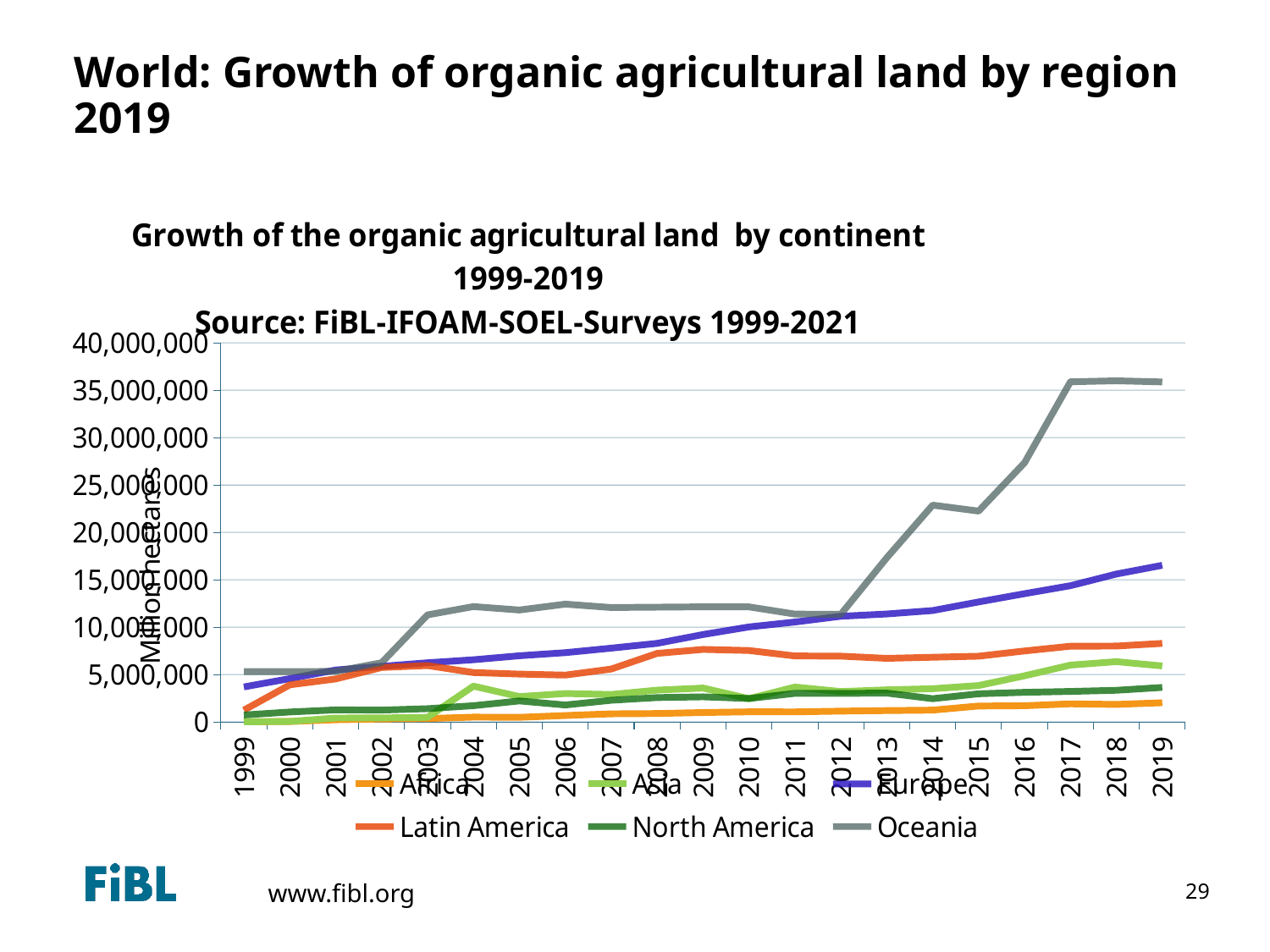
Which region has the highest organic agricultural land in 2019? Oceania Which region has the lowest organic agricultural land in 2019? Africa Is the value for Europe in 1999 greater or less than 5,000,000? less How many series does the legend list? 6 In 2019, which is larger: Europe or Latin America? Europe Is the value for Oceania in 2019 greater or less than 30,000,000? greater What kind of chart is shown on the slide? Line chart What is the label on the vertical axis? Million hectares How many years are plotted along the x axis? 21 Is the value for Europe in 2019 greater or less than 15,000,000? greater In 2019, which is larger: Asia or North America? Asia Does the Europe line rise or fall from 1999 to 2019? Rise